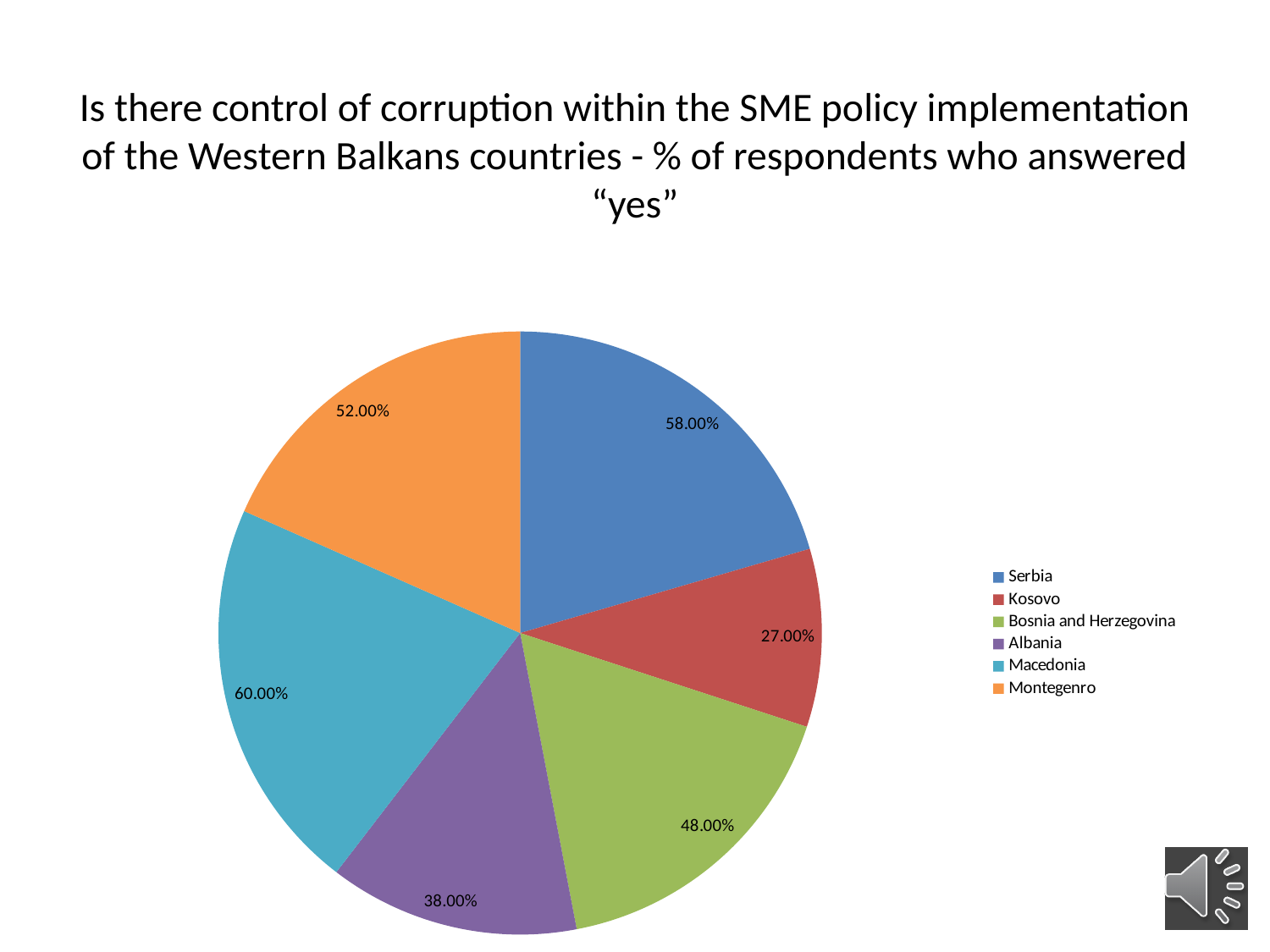
How many countries are shown in the pie chart? 6 Which has a larger value, Albania or Bosnia and Herzegovina? Bosnia and Herzegovina What is the difference between the values for Serbia and Kosovo? 31.00% What kind of chart is shown on the slide? Pie chart What value is shown for Macedonia? 60.00% What value is shown for Bosnia and Herzegovina? 48.00% What value is shown for Serbia? 58.00% What value is shown for Albania? 38.00% What colour is the slice for Macedonia? Teal (light blue) Which country has the lowest value in the pie chart? Kosovo What value is shown for Kosovo? 27.00% Which country has the highest value in the pie chart? Macedonia